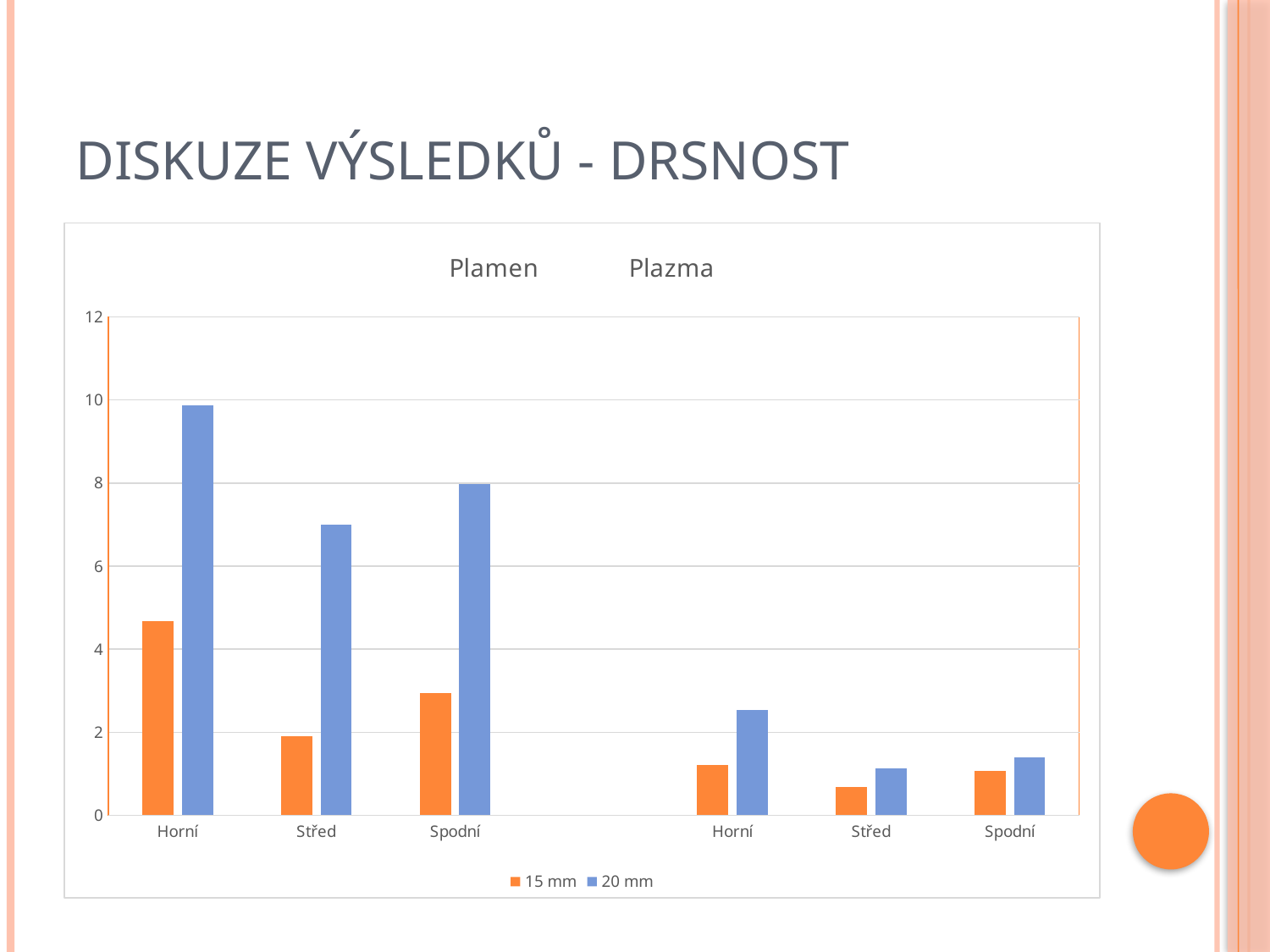
Is the 20 mm value for Horní under Plazma greater or less than 4? less Which is larger: the 20 mm value for Spodní under Plamen or the 20 mm value for Spodní under Plazma? Spodní under Plamen Is the 20 mm value for Spodní under Plamen greater or less than 6? greater Which category has the highest 20 mm value? Horní (Plamen) What are the two series named in the legend? 15 mm and 20 mm Which is larger for Střed under Plamen: the 15 mm value or the 20 mm value? 20 mm How many series does the legend list? 2 How many category groups are shown along the x axis? 6 Is the 20 mm value for Horní under Plamen greater or less than 8? greater What kind of chart is shown on the slide? bar chart Which category has the lowest 15 mm value? Střed (Plazma)